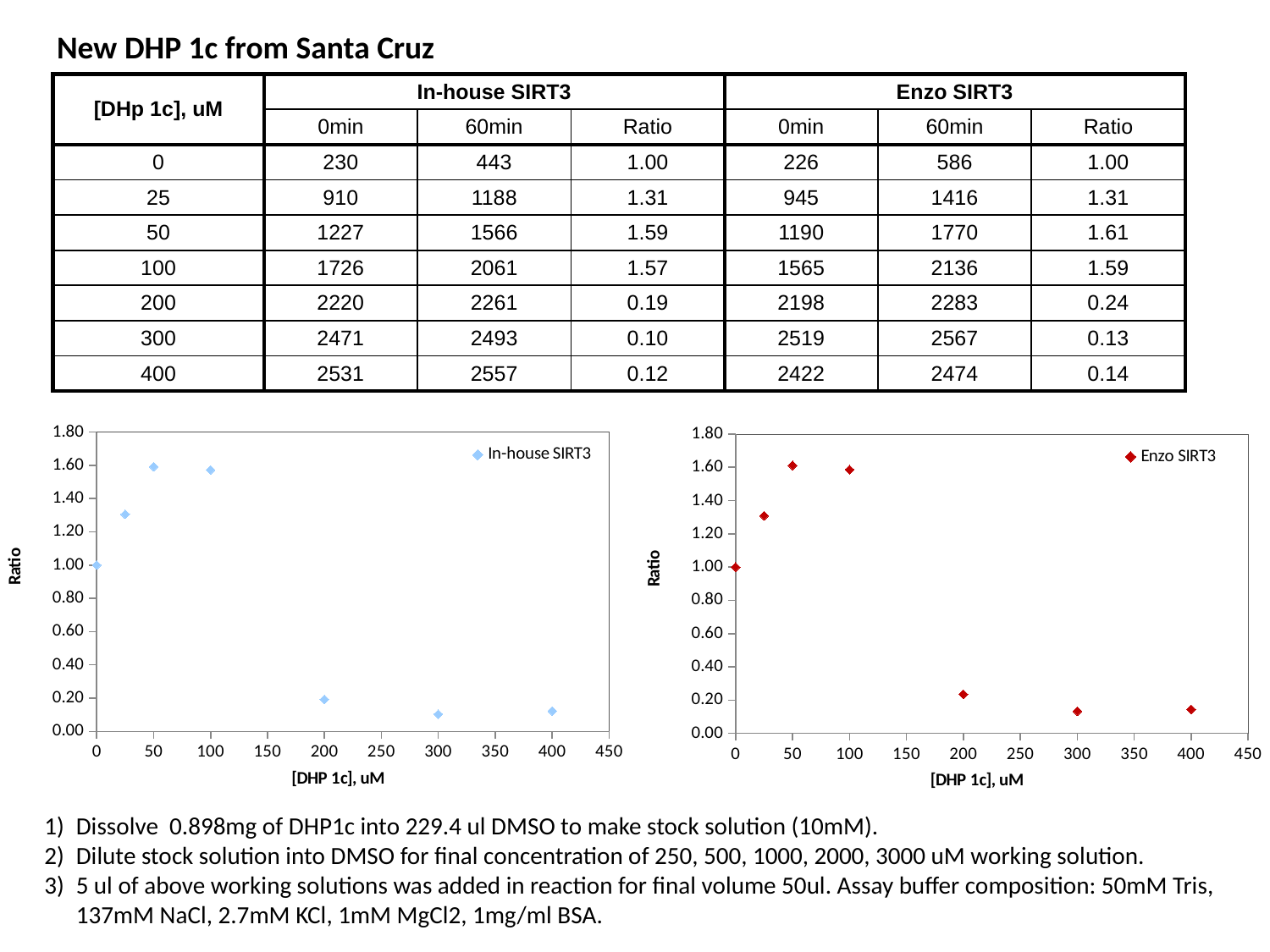
In the right chart (Enzo SIRT3), do the ratios rise or fall from 100 uM to 400 uM? fall What kind of chart is the left chart (In-house SIRT3)? scatter chart In the left chart (In-house SIRT3), is the ratio at 200 uM greater or less than 0.40? less What is the legend entry shown in the right chart? Enzo SIRT3 In the right chart (Enzo SIRT3), which concentration has the larger ratio, 100 uM or 300 uM? 100 uM What is the x-axis title of the left chart (In-house SIRT3)? [DHP 1c], uM How many data points are plotted in the left chart (In-house SIRT3)? 7 In the right chart (Enzo SIRT3), what is the ratio at 200 uM DHP 1c? 0.24 In the left chart (In-house SIRT3), what is the difference between the ratio at 100 uM and the ratio at 200 uM? 1.38 In the right chart (Enzo SIRT3), is the ratio at 50 uM greater or less than 1.40? greater In the left chart (In-house SIRT3), what is the ratio at 25 uM DHP 1c? 1.31 How many series does the legend of the right chart (Enzo SIRT3) list? 1